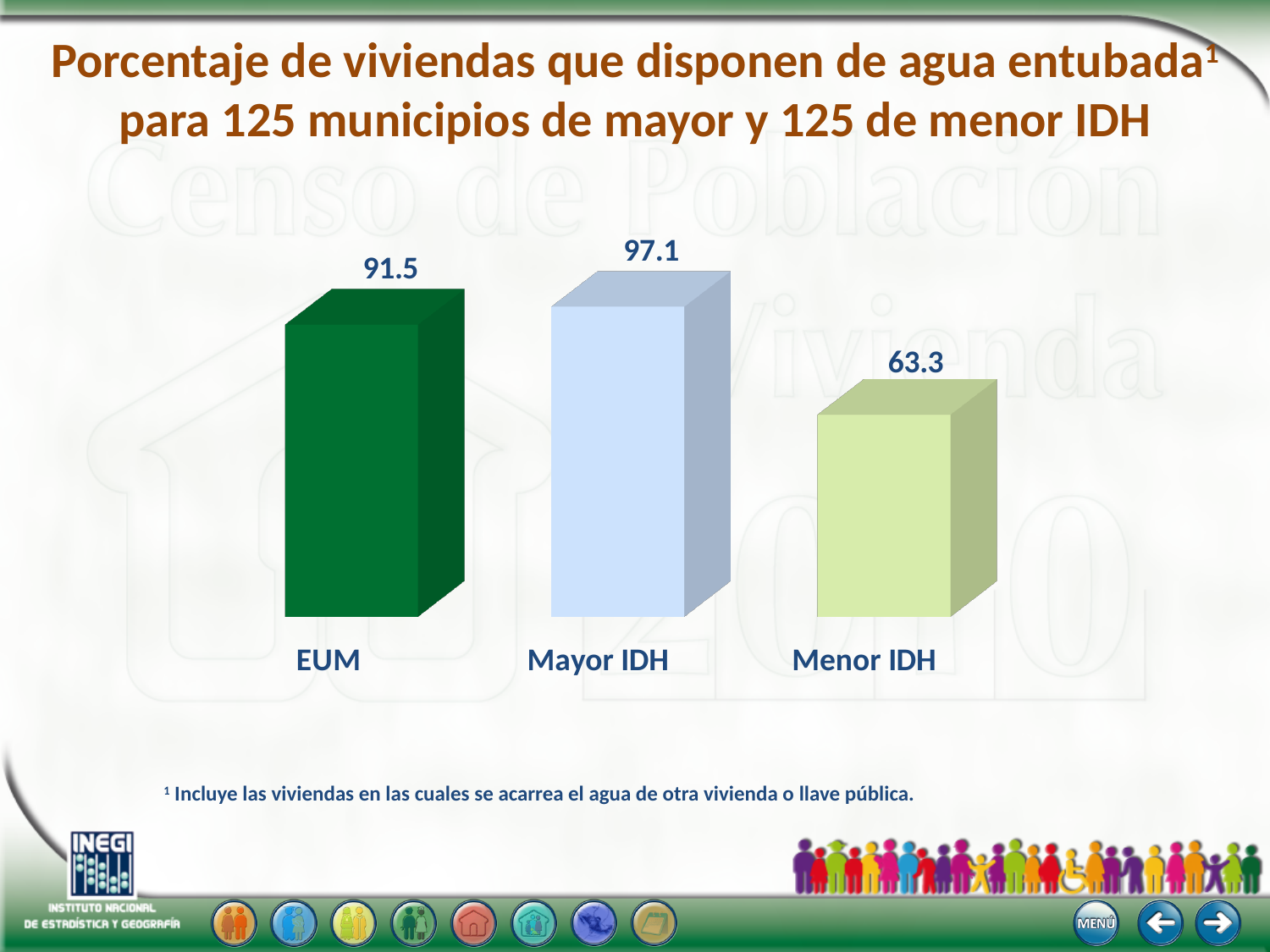
What is the value for Menor IDH? 63.3 Which is larger, the value for EUM or the value for Menor IDH? EUM Which category has the highest value? Mayor IDH What colour is the bar for EUM? Dark green What is the difference between the values for Mayor IDH and EUM? 5.6 What kind of chart is shown on the slide? Bar chart How many categories are shown in the chart? 3 What is the value for Mayor IDH? 97.1 What is the value for EUM? 91.5 Which category has the lowest value? Menor IDH What is the title of the chart? Porcentaje de viviendas que disponen de agua entubada para 125 municipios de mayor y 125 de menor IDH What is the difference between the values for Mayor IDH and Menor IDH? 33.8